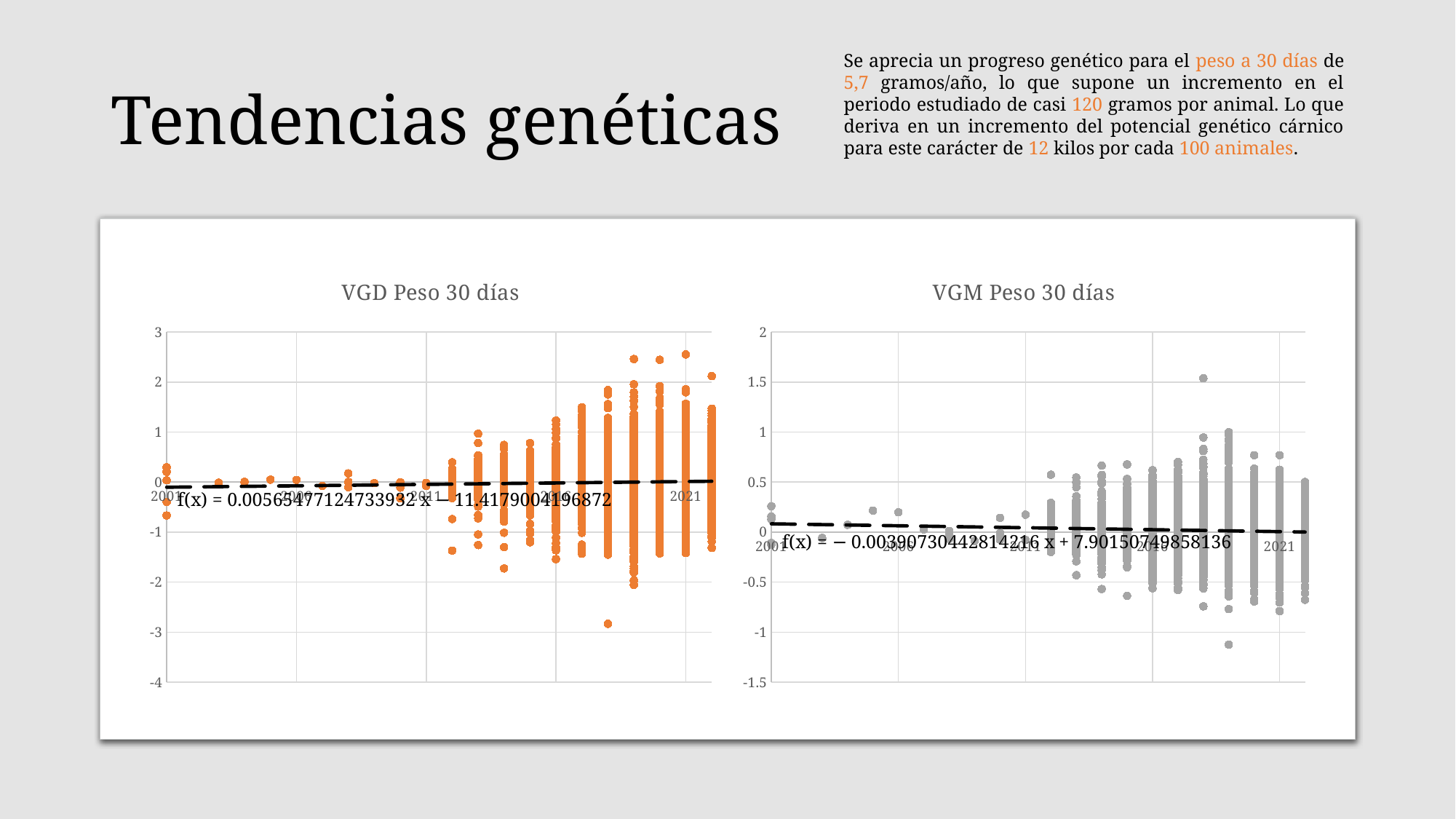
In the 'VGD Peso 30 días' chart, is the highest plotted point greater or less than 2? greater In the 'VGM Peso 30 días' chart, is the lowest plotted point greater or less than -0.5? less What are the titles of the two charts on the slide? VGD Peso 30 días and VGM Peso 30 días In the 'VGM Peso 30 días' chart, is the highest plotted point greater or less than 1? greater In the 'VGD Peso 30 días' chart, does the dashed trendline rise or fall from left to right? rises In the 'VGM Peso 30 días' chart, does the dashed trendline rise or fall from left to right? falls What kind of chart is the 'VGM Peso 30 días' chart? scatter chart What is the trendline equation shown on the 'VGD Peso 30 días' chart? f(x) = 0.00565477124733932 x − 11.4179004196872 What kind of chart is the 'VGD Peso 30 días' chart? scatter chart